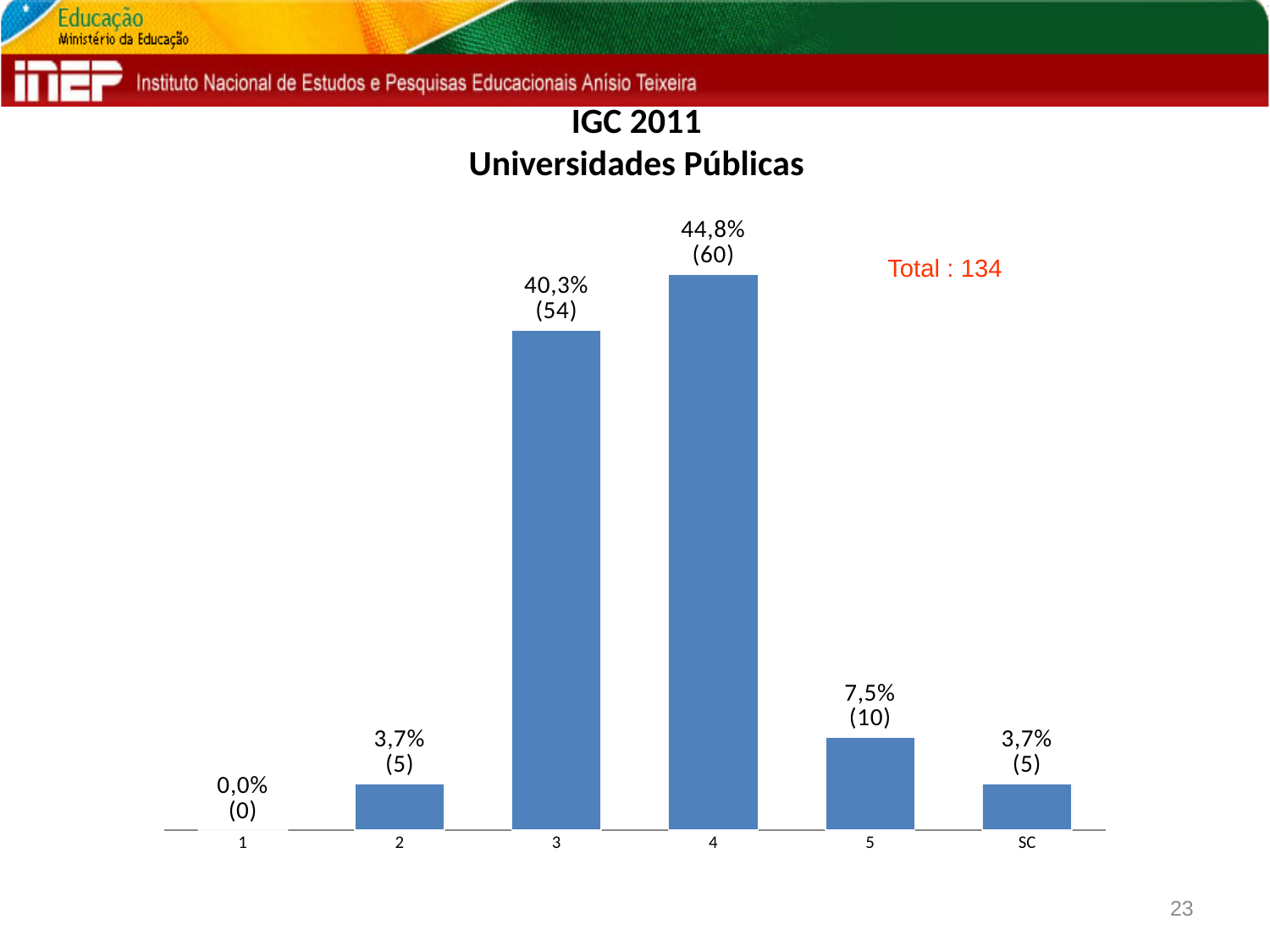
How many categories are shown on the x axis? 6 What count is shown for the SC category? 5 What percentage is shown for category 4? 44,8% What percentage is shown for category 5? 7,5% Which category has the lowest value? 1 What total is stated on the slide? 134 How many universities are in category 3? 54 Which is larger, the value for category 3 or category 5? 3 What is the difference in count between category 4 and category 3? 6 Which category has the highest value? 4 What kind of chart is this? bar chart What is the difference in percentage between category 5 and category 2? 3,8%